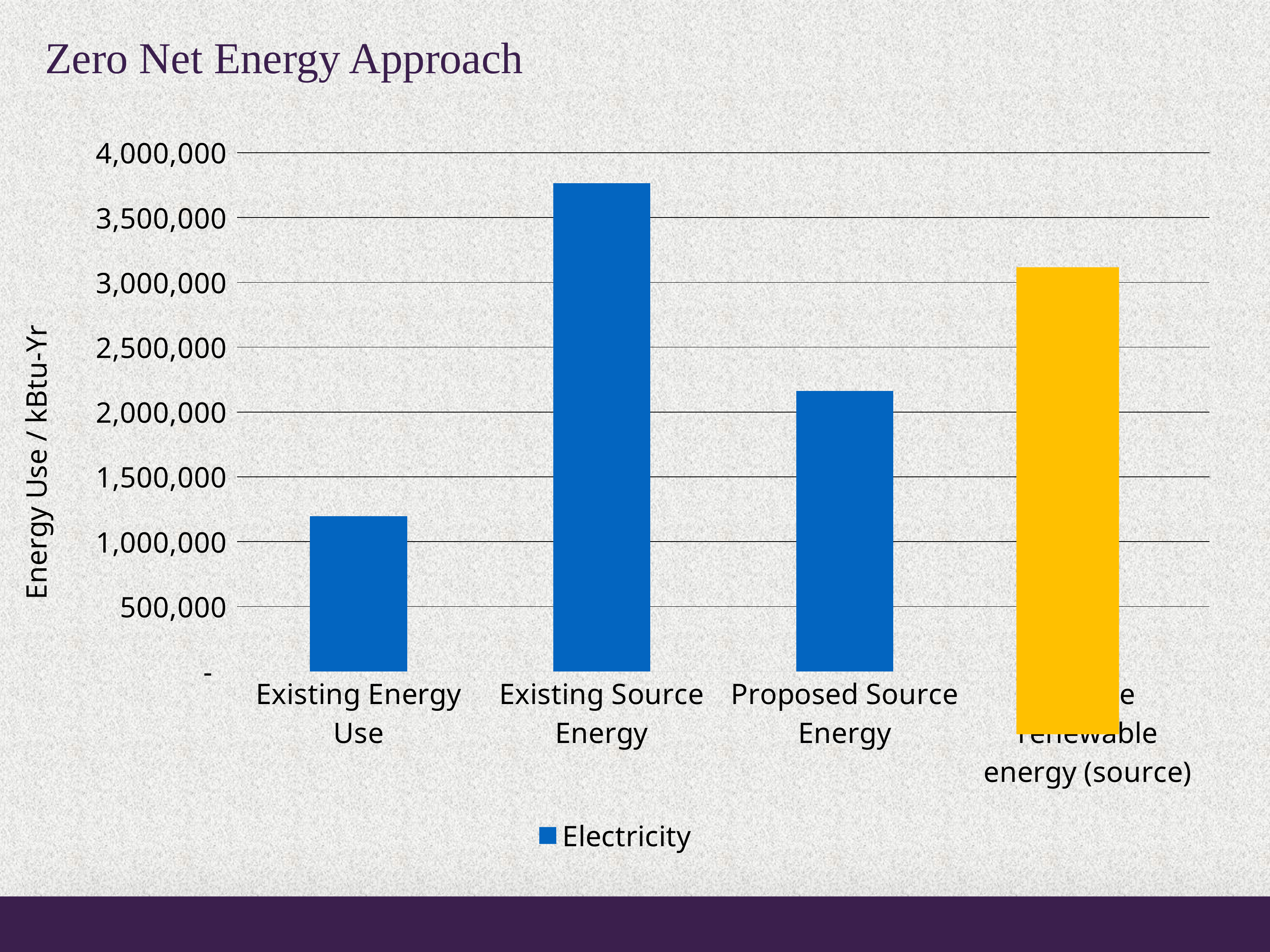
Is the value for Existing Energy Use greater or less than 1,000,000? greater Which category has the highest bar? Existing Source Energy What kind of chart is shown on the slide? bar chart Is the value for Proposed Source Energy greater or less than 2,500,000? less What is the label on the vertical axis? Energy Use / kBtu-Yr Which is larger, Existing Energy Use or Proposed Source Energy? Proposed Source Energy Which is larger, Existing Source Energy or Proposed Source Energy? Existing Source Energy Which category has the lowest bar? Existing Energy Use How many bars are plotted in the chart? 4 What is the series name shown in the legend? Electricity How many series does the legend list? 1 Is the value for Existing Source Energy greater or less than 3,500,000? greater